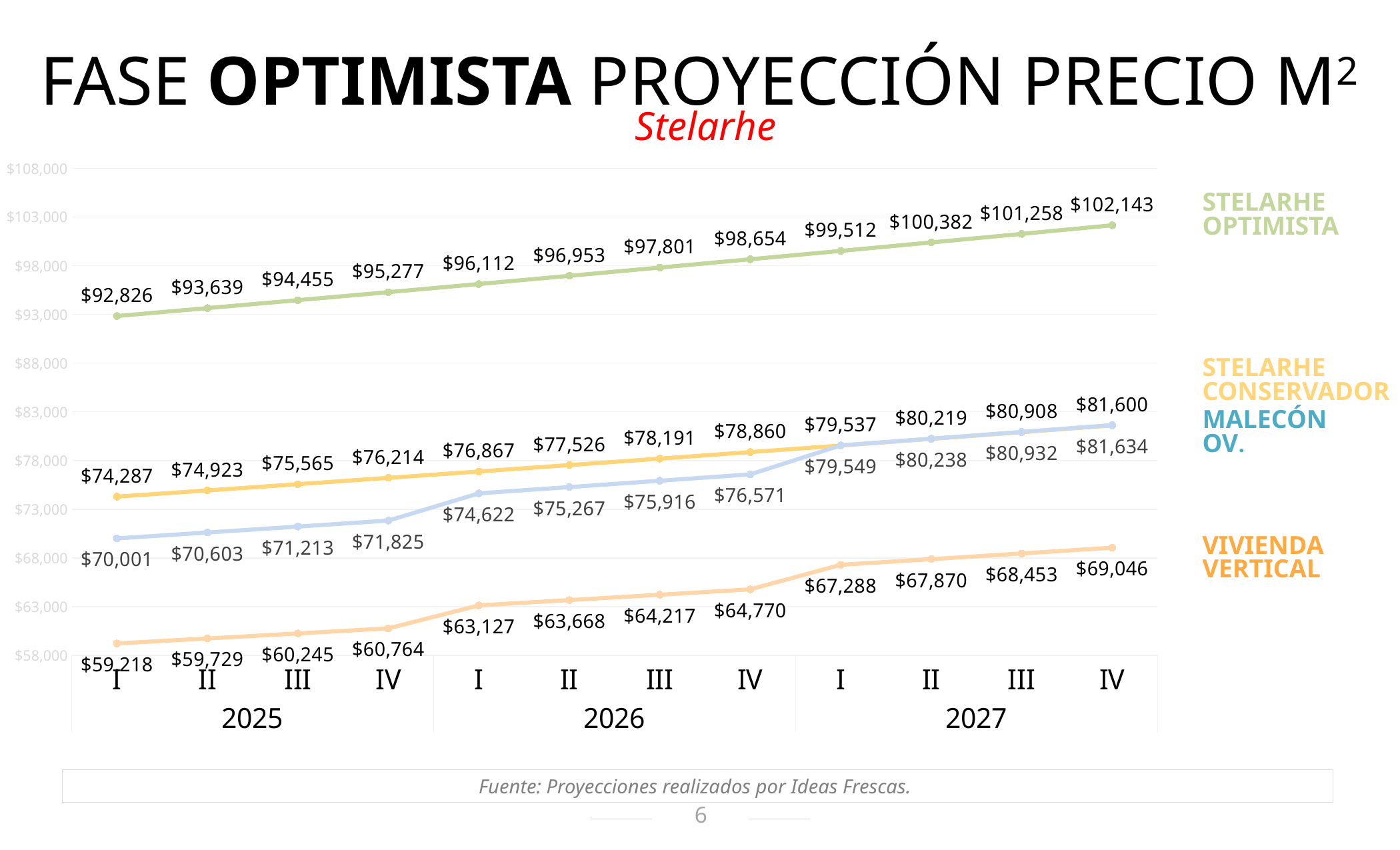
What is the Stelarhe Conservador value for quarter III of 2027? $80,908 What kind of chart is shown on the slide? line chart How many quarterly points are plotted along the x axis? 12 What is the Malecón OV. value for quarter I of 2026? $74,622 Which series has the highest value in quarter IV of 2027? Stelarhe Optimista Which is larger in quarter I of 2025: the Malecón OV. value or the Vivienda Vertical value? Malecón OV. What is the difference between the Stelarhe Optimista values for quarter IV of 2027 and quarter I of 2025? $9,317 How many series does the chart show? 4 Is the Vivienda Vertical value for quarter IV of 2027 greater or less than $68,000? greater What is the Stelarhe Optimista value for quarter I of 2025? $92,826 What is the Vivienda Vertical value for quarter IV of 2027? $69,046 Which series has the lowest value in quarter I of 2025? Vivienda Vertical